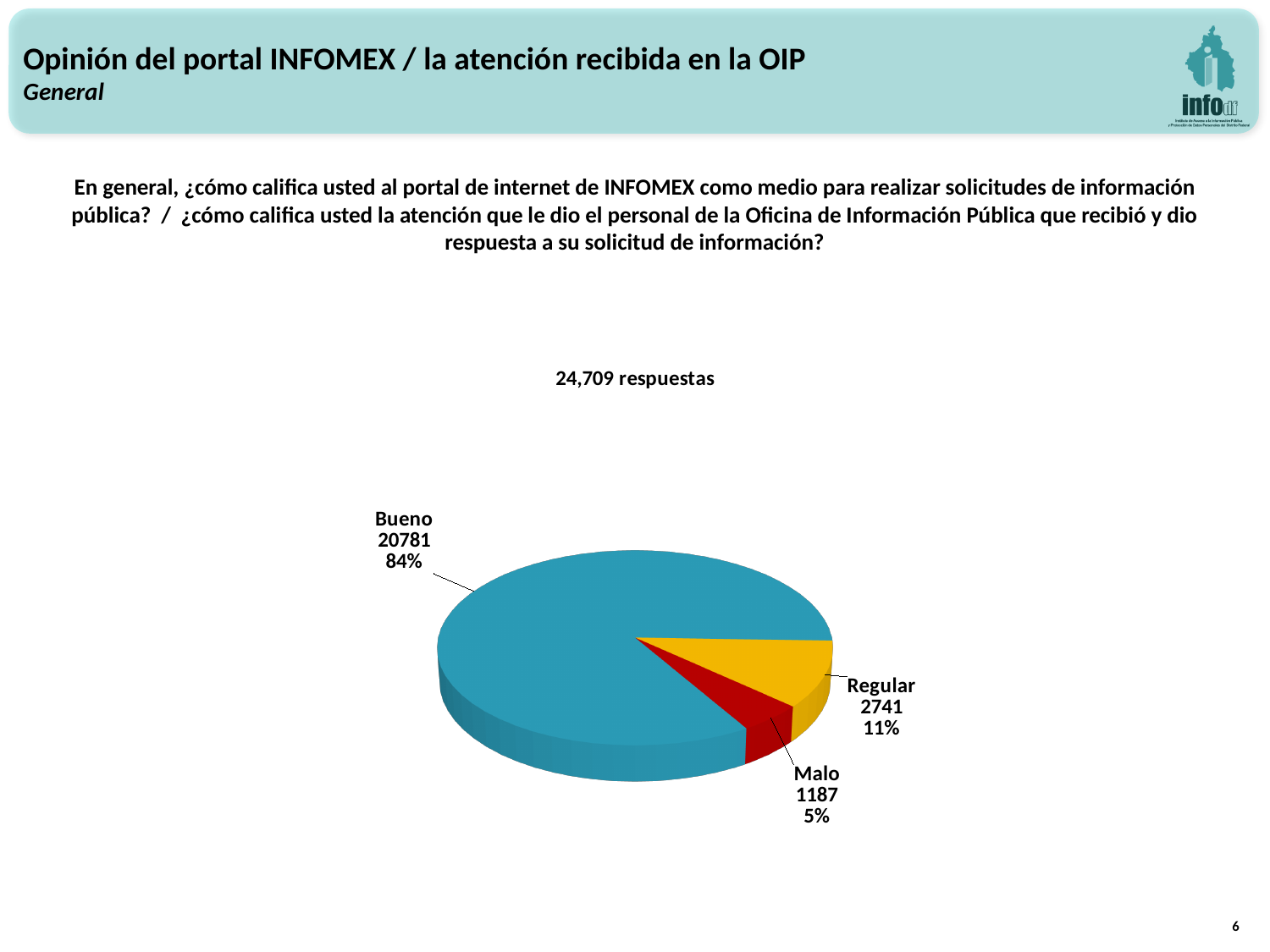
What share of the pie does Bueno represent? 84% Which category has the smallest slice? Malo What is the value for Malo? 1187 What is the difference between the values for Regular and Malo? 1554 Which is larger, the value for Regular or the value for Malo? Regular What share of the pie does Malo represent? 5% Which category has the largest slice? Bueno How many slices does the pie chart have? 3 What is the value for Bueno? 20781 What is the value for Regular? 2741 What is the total number of responses stated above the chart? 24,709 respuestas What kind of chart is shown on the slide? pie chart